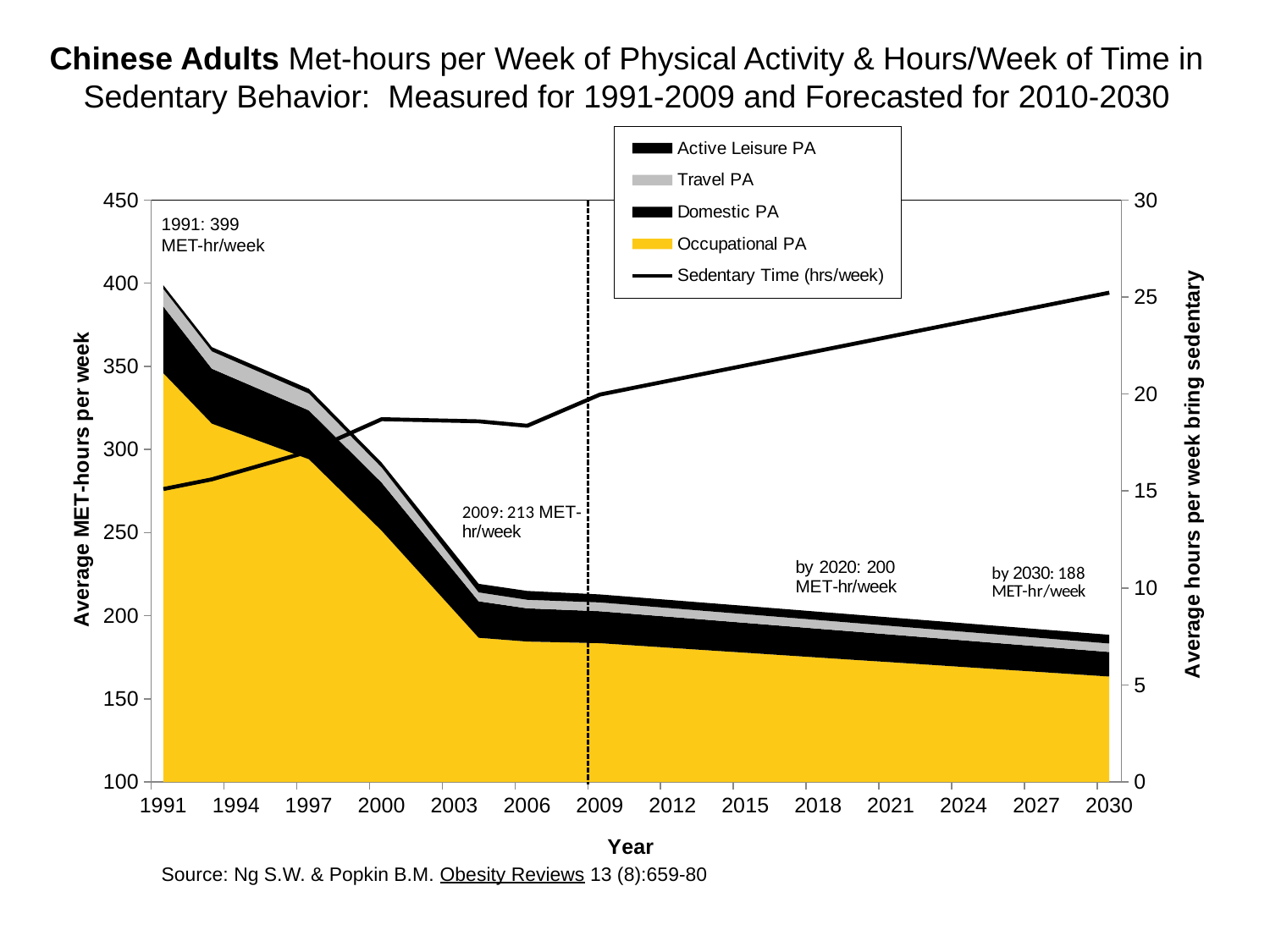
How many series does the legend list? 5 What was the total physical activity in MET-hr/week in 2009? 213 MET-hr/week Does sedentary time (hrs/week) rise or fall overall from 1991 to 2030? Rise What was the total physical activity in MET-hr/week for Chinese adults in 1991? 399 MET-hr/week Is the sedentary time in 1991 greater or less than 20 hours per week? less What is the difference between the forecasted total physical activity for 2020 and for 2030? 12 MET-hr/week Is the sedentary time in 2030 greater or less than 20 hours per week? greater What is the forecasted total physical activity in MET-hr/week by 2030? 188 MET-hr/week What kind of chart is shown on the slide? Stacked area chart with a line Which colour represents Occupational PA in the chart? Yellow Which year has the higher total physical activity, 1991 or 2030? 1991 By how many MET-hr/week did total physical activity fall between 1991 and 2009? 186